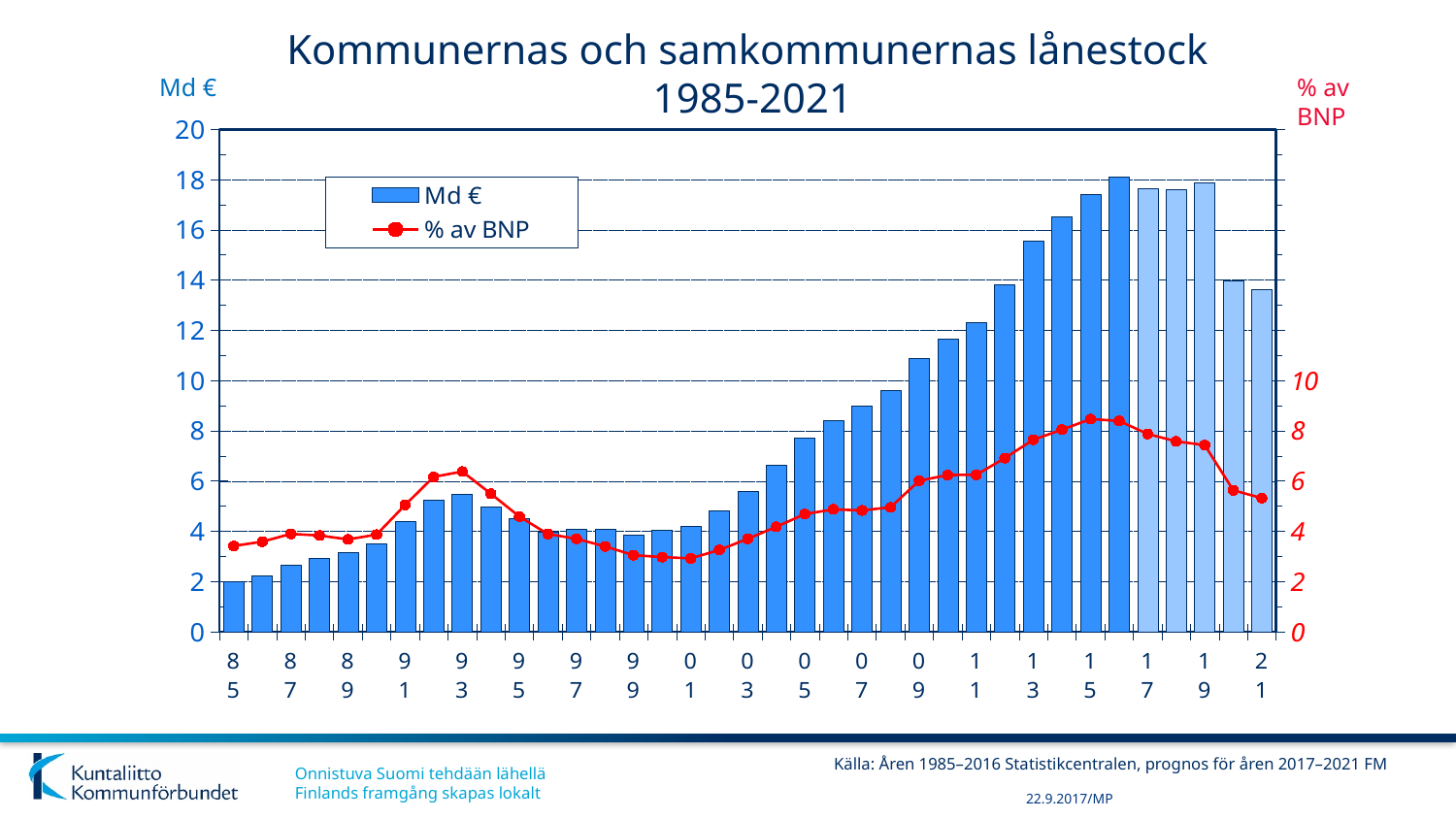
Which is larger, the % av BNP value for 1993 or for 1985? 1993 Which year has the lowest Md € bar? 1985 Is the Md € value for 2021 greater or less than 14? less Is the % av BNP value for 1993 greater or less than 6? greater Is the Md € value for 2013 greater or less than 14? greater How many series does the legend list? 2 What are the two series named in the legend? Md € and % av BNP What kind of chart is shown on the slide? A combined bar and line chart Do the Md € bars rise or fall from 2001 to 2015? rise What is the title of the chart? Kommunernas och samkommunernas lånestock 1985-2021 Which is larger, the Md € bar for 2019 or the Md € bar for 2021? 2019